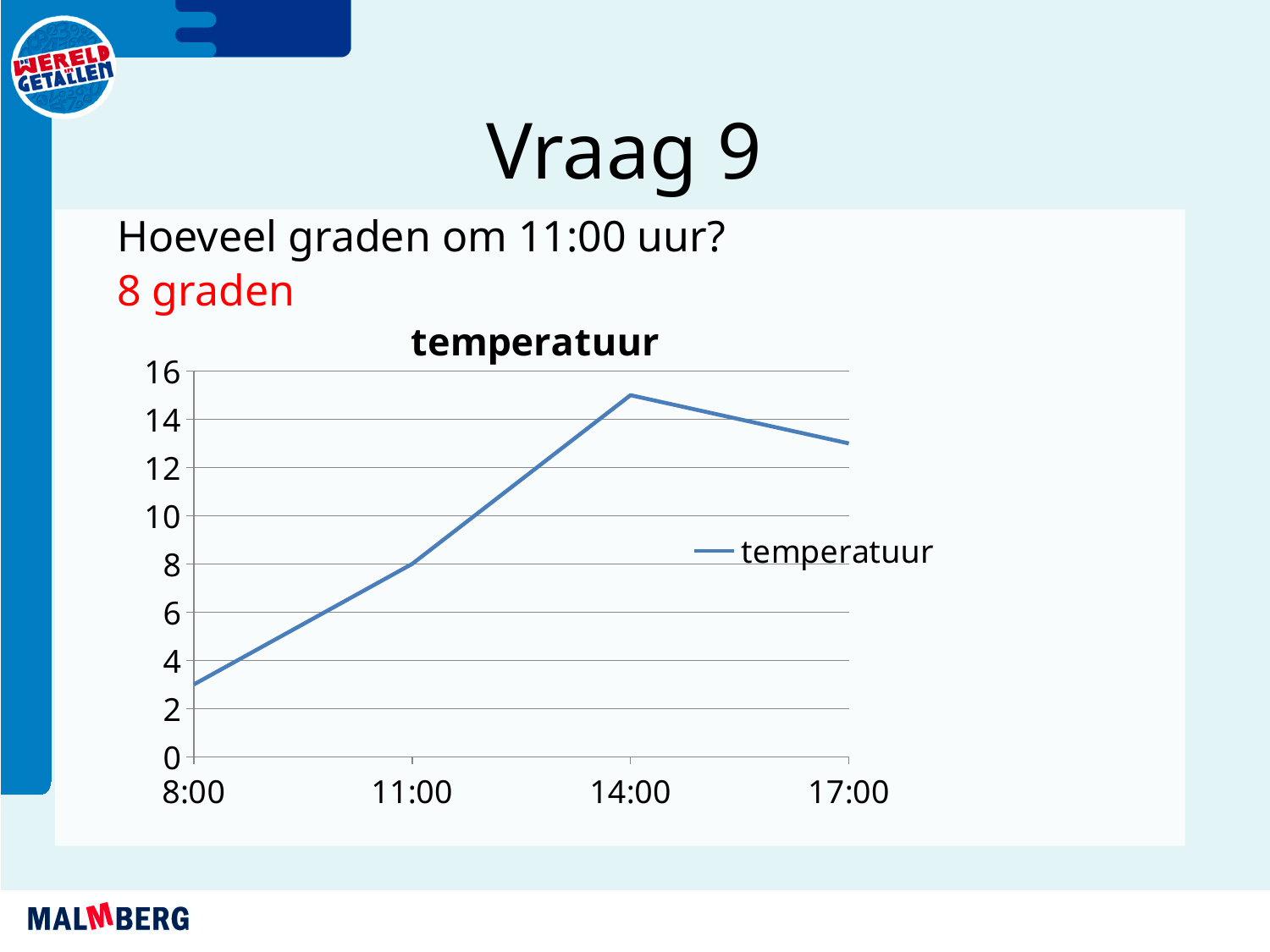
What is the title of the chart? temperatuur Does the temperature rise or fall between 8:00 and 14:00? rise At which time is the temperature lowest? 8:00 Is the value for 8:00 greater or less than 4? less Which is higher, the temperature at 14:00 or at 17:00? 14:00 What kind of chart is shown on the slide? line chart What is the temperature at 11:00 according to the slide? 8 graden Is the value for 14:00 greater or less than 14? greater Is the value for 17:00 greater or less than 12? greater At which time is the temperature highest? 14:00 How many time points are plotted on the chart? 4 How many series does the legend list? 1